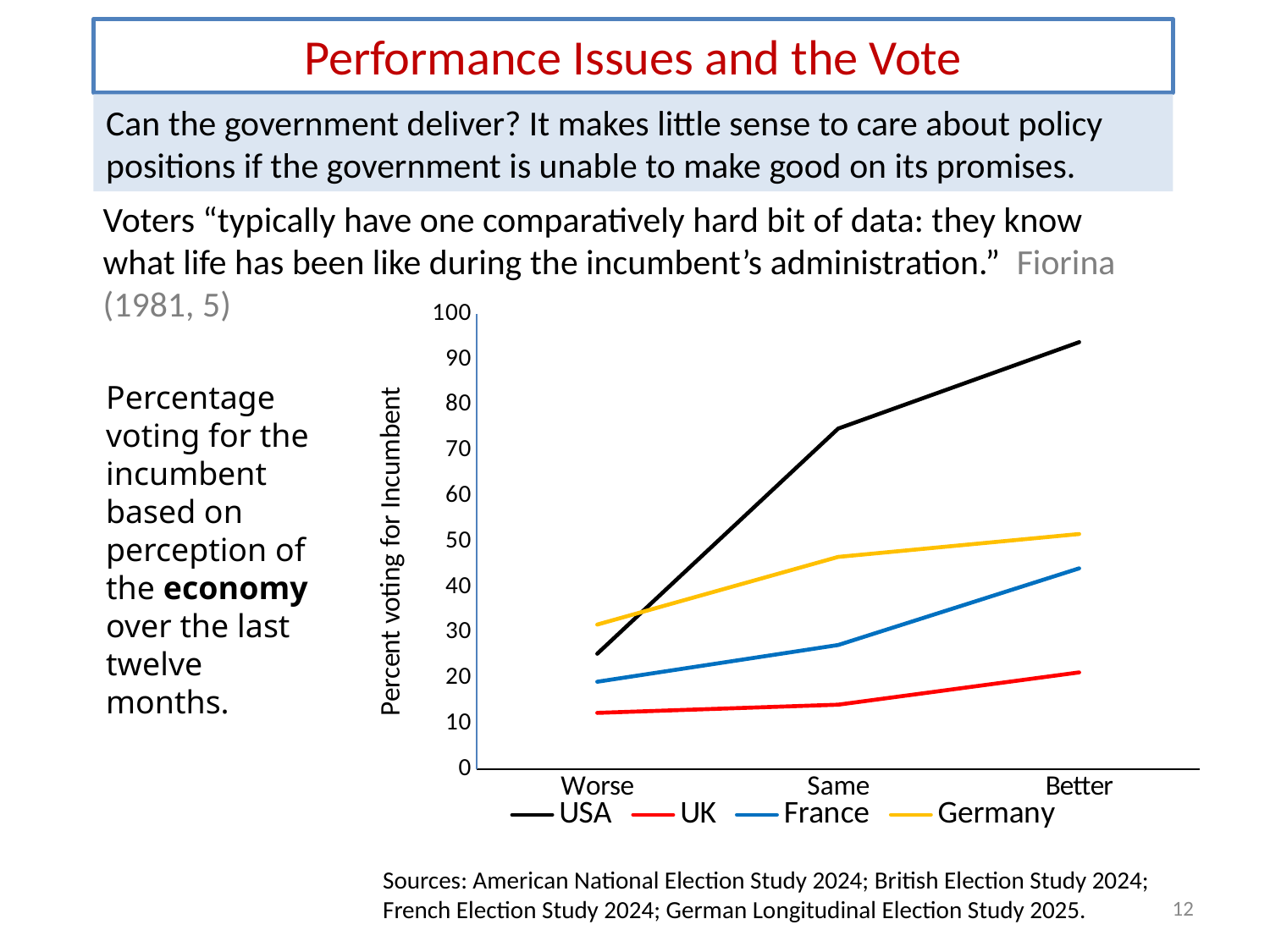
What kind of chart is shown on the slide? Line chart Which series has the highest value at the 'Worse' category? Germany How many series does the chart's legend list? 4 Which is larger at the 'Same' category, the value for USA or the value for Germany? USA Is the value for USA at 'Better' greater or less than 90? greater Is the value for Germany at 'Same' greater or less than 40? greater Which series has the highest value at the 'Better' category? USA Which series has the lowest value at the 'Worse' category? UK Does the USA line rise or fall from 'Worse' to 'Better'? Rises How many categories are shown on the x axis of the chart? 3 What is the title of the chart's vertical axis? Percent voting for Incumbent Is the value for UK at 'Worse' greater or less than 20? less